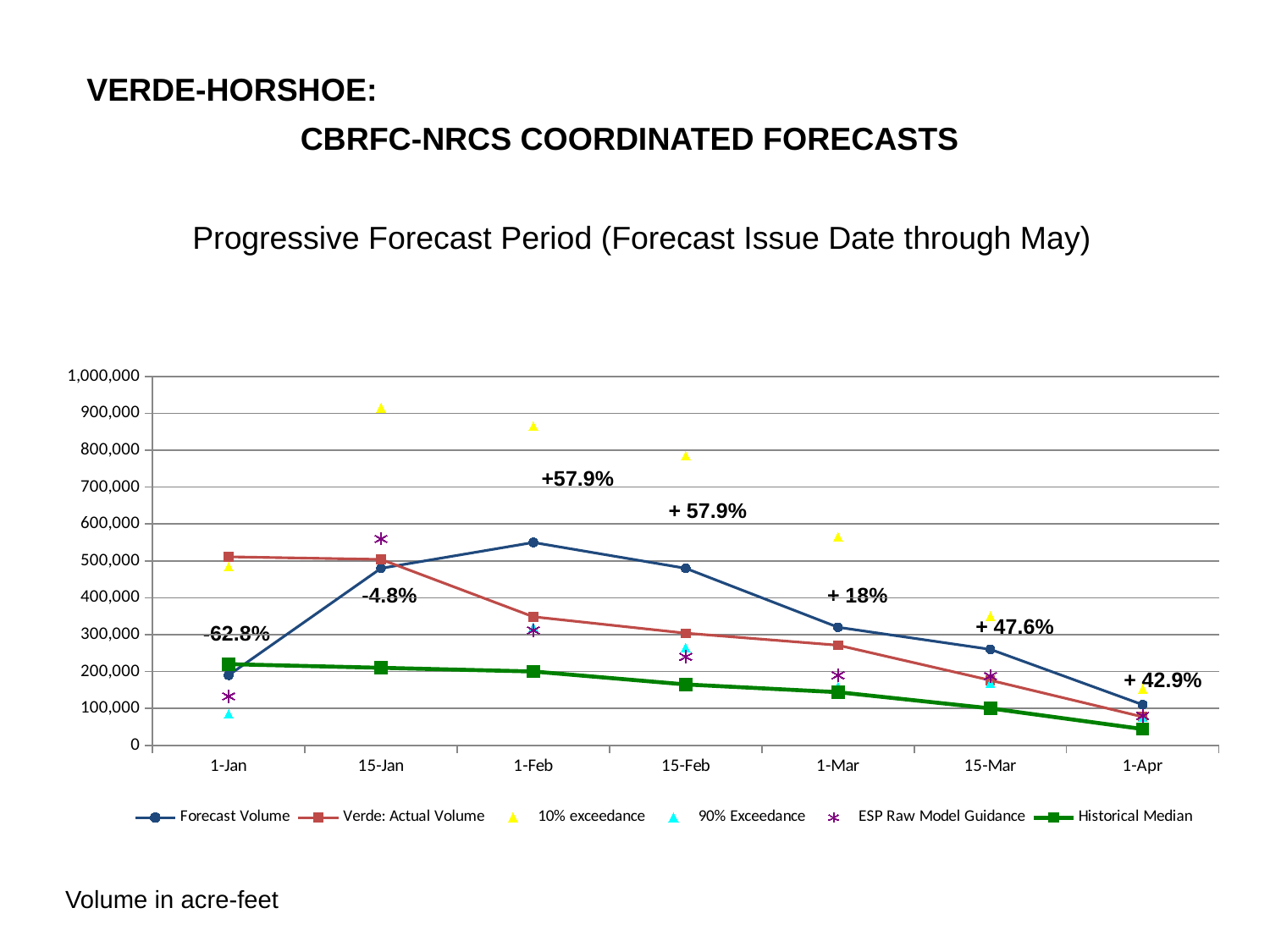
On which date is the Forecast Volume highest? 1-Feb Is the Forecast Volume at 1-Feb greater or less than 500,000? greater On which date is the Historical Median lowest? 1-Apr Is the Historical Median at 1-Apr greater or less than 100,000? less At 1-Jan, which is larger: the Forecast Volume or the Verde: Actual Volume? Verde: Actual Volume On which date is the Forecast Volume lowest? 1-Apr How many series does the legend list? 6 How many dates are shown along the x axis? 7 What kind of chart is shown on the slide? line chart Does the Historical Median rise or fall from 1-Jan to 1-Apr? fall At 1-Feb, which is larger: the Forecast Volume or the Verde: Actual Volume? Forecast Volume